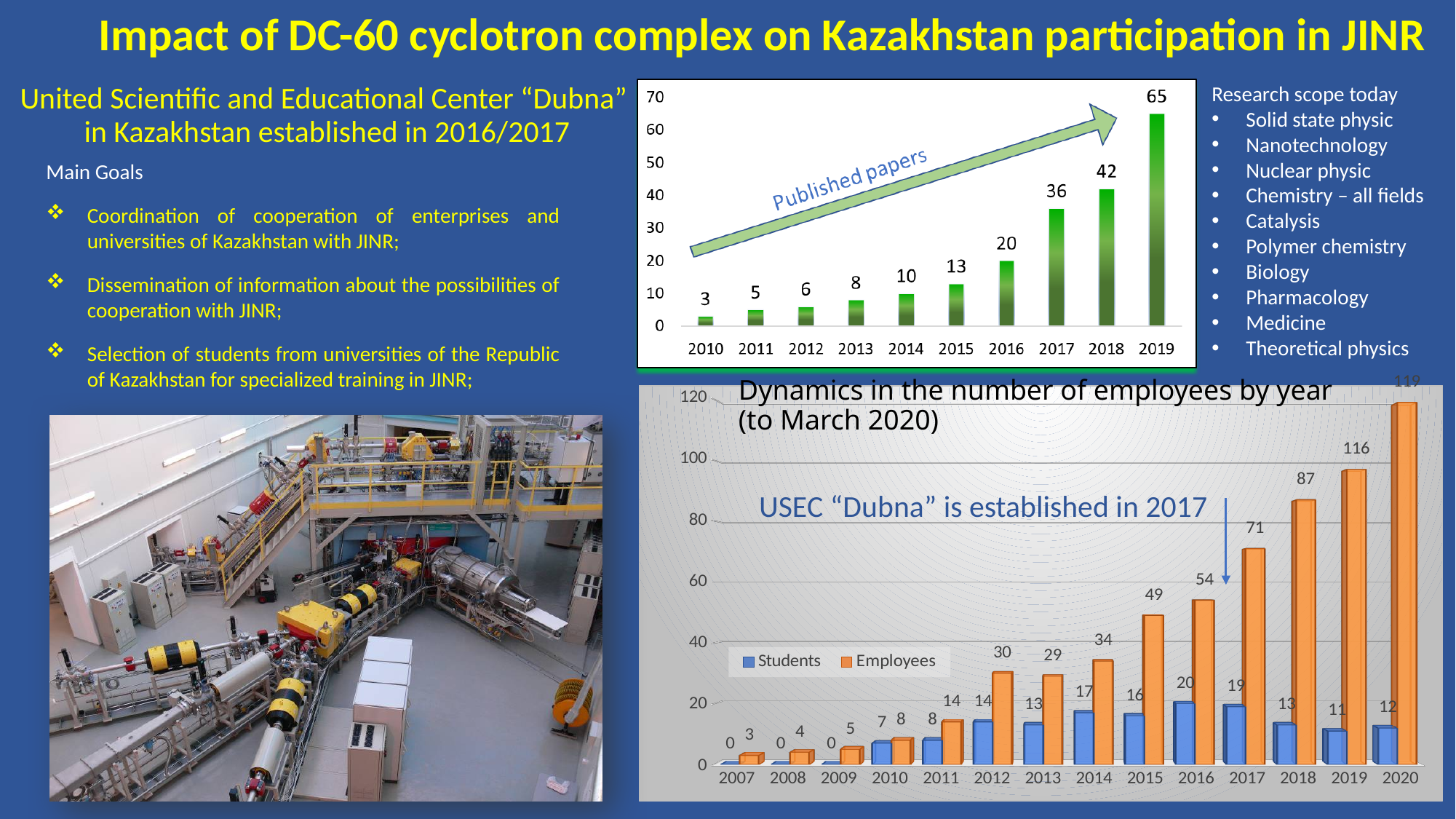
In the Published papers chart, do the values rise or fall from 2010 to 2019? rise In the chart 'Dynamics in the number of employees by year', which year has the highest Students value? 2016 In the chart 'Dynamics in the number of employees by year', what is the Students value for 2016? 20 In the Published papers chart, what is the difference between the 2019 and 2018 values? 23 In the Published papers chart, how many papers were published in 2019? 65 In the chart 'Dynamics in the number of employees by year', how many series does the legend list? 2 What type of chart is 'Dynamics in the number of employees by year'? bar chart In the chart 'Dynamics in the number of employees by year', which is larger in 2017: Students or Employees? Employees In the Published papers chart, how many years are shown on the x axis? 10 In the chart 'Dynamics in the number of employees by year', what is the Employees value for 2020? 119 In the Published papers chart, how many papers were published in 2016? 20 In the Published papers chart, which year has the lowest number of published papers? 2010